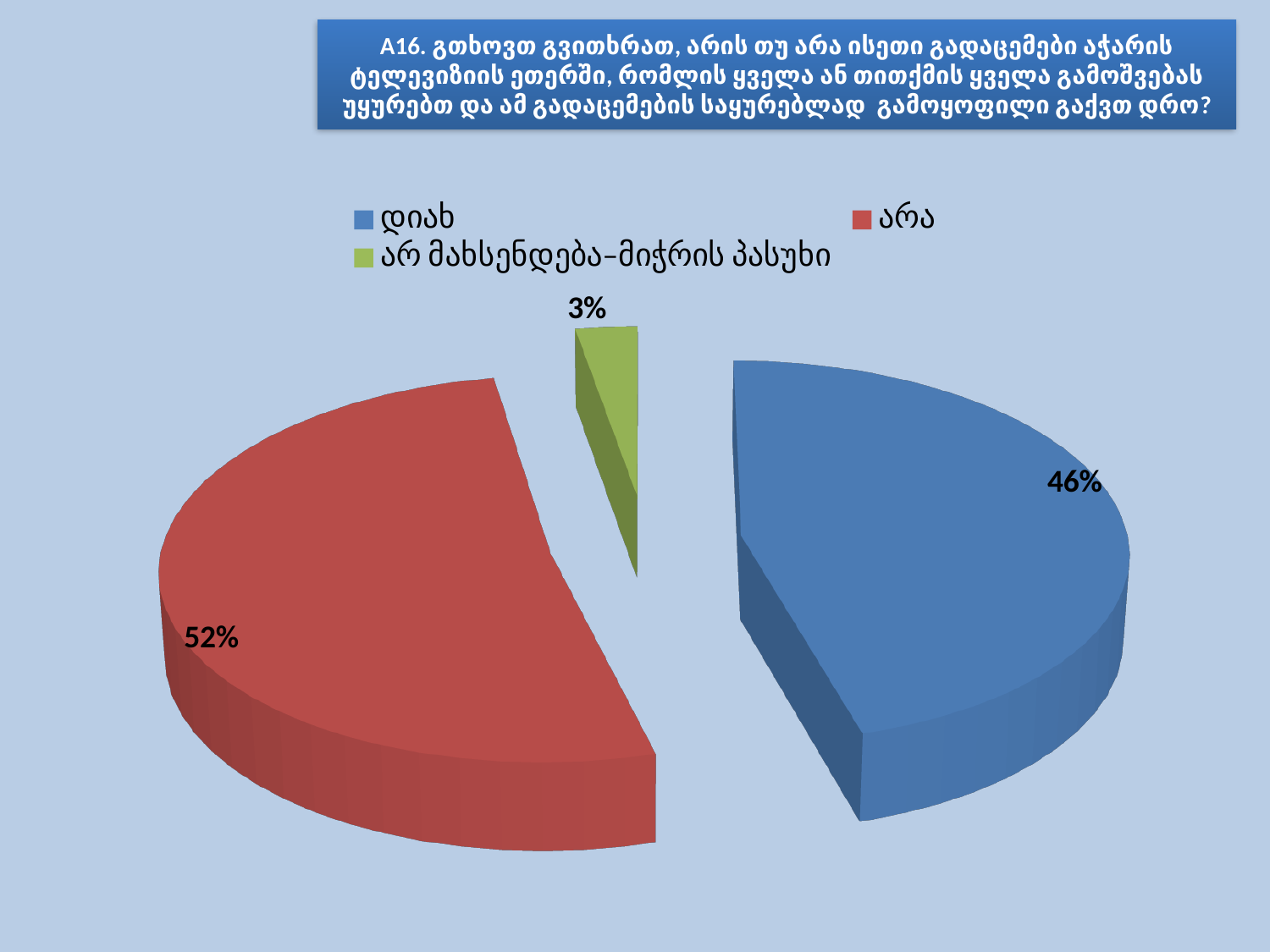
Which category has the smallest share of the pie? არ მახსენდება–მიჭრის პასუხი What percentage is shown for the "დიახ" slice? 46% What percentage is shown for the "არ მახსენდება-მიჭირს პასუხი" slice? 3% What colour is the "დიახ" slice? blue What kind of chart is shown on the slide? pie chart What percentage is shown for the "არა" slice? 52% What is the difference in percentage points between the "არა" and "დიახ" slices? 6 How many entries does the legend list? 3 How many slices does the pie chart have? 3 What colour is the "არა" slice? red Which is larger, the "დიახ" slice or the "არა" slice? არა Which category has the largest share of the pie? არა